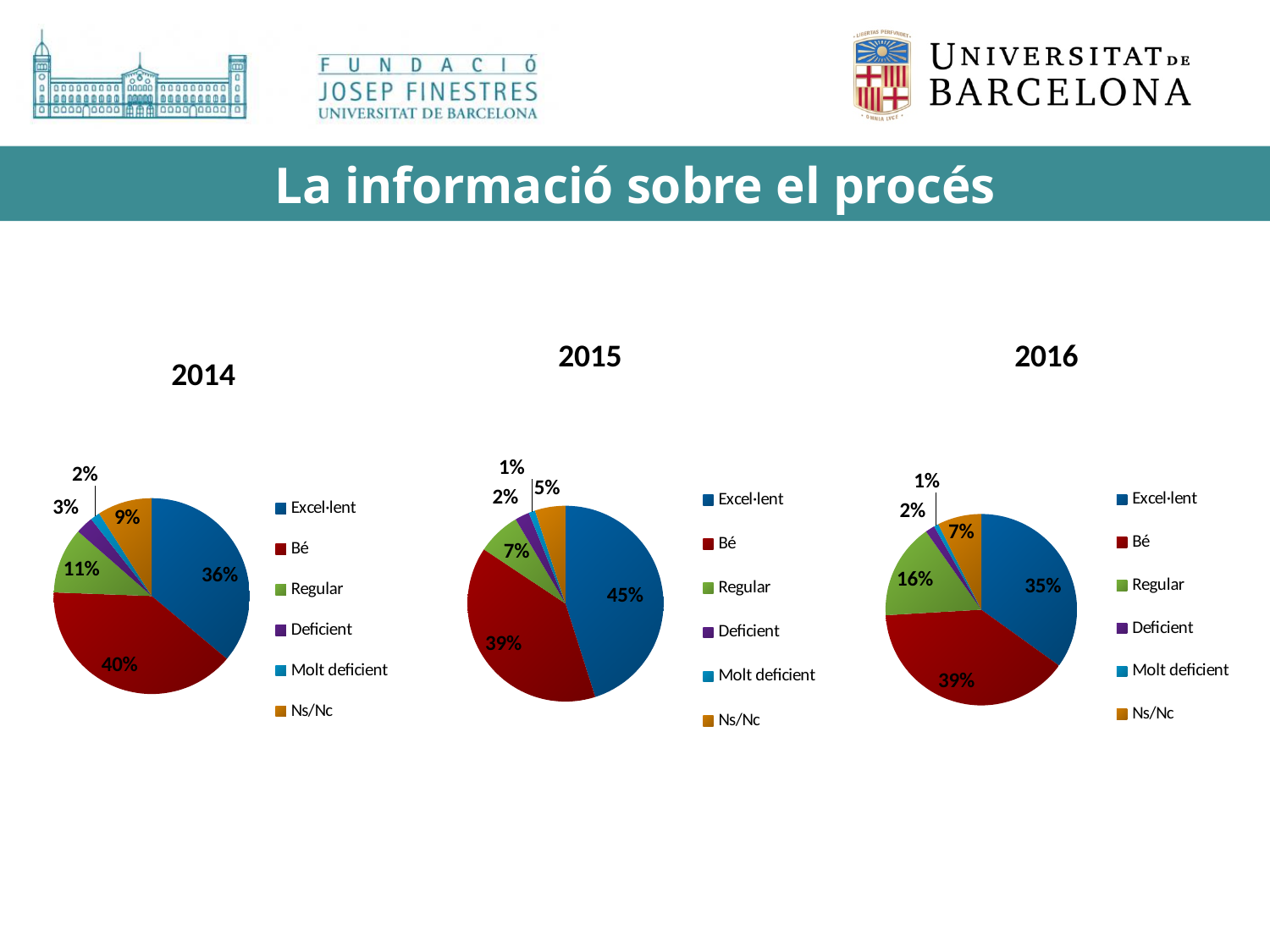
In the 2015 pie chart, which category has the largest share? Excel·lent In the 2015 pie chart, which category has the smallest share? Molt deficient What type of chart is used for the 2014 data? Pie chart How many categories does the legend of the 2015 pie chart list? 6 In the 2016 pie chart, what percentage is shown for Ns/Nc? 7% In the 2016 pie chart, what is the difference in percentage points between Bé and Excel·lent? 4 In the 2014 pie chart, what percentage is shown for Bé? 40% How many pie charts are shown on the slide? 3 In the 2016 pie chart, what percentage is shown for Regular? 16% In the 2014 pie chart, which is larger, the share for Regular or the share for Ns/Nc? Regular In the 2014 pie chart, which category has the largest share? Bé In the 2015 pie chart, what percentage is shown for Excel·lent? 45%